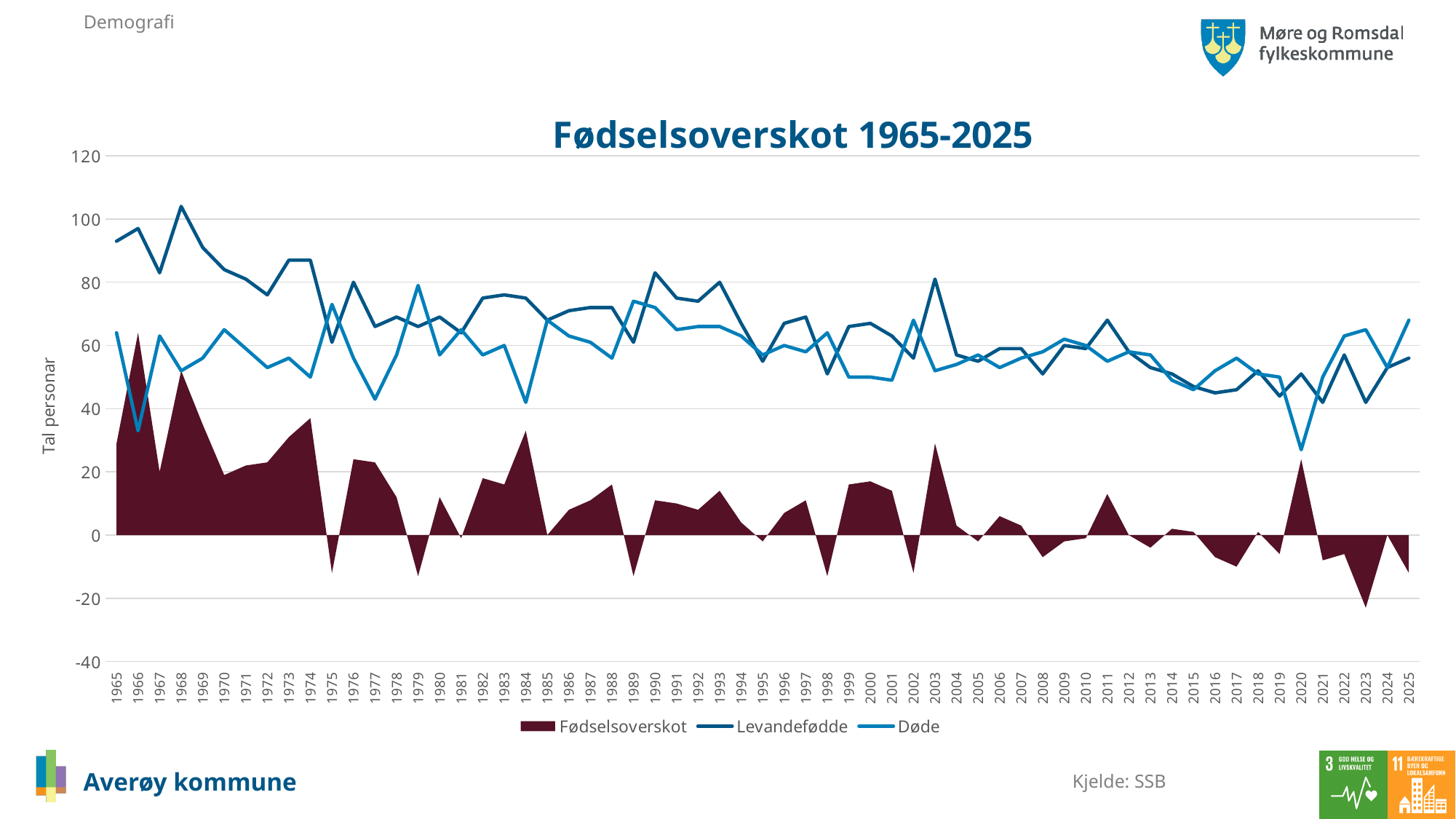
Does the Levandefødde series overall rise or fall from 1965 to 2025? fall Is the value for Fødselsoverskot in 2023 greater or less than -20? less What is the title of the chart? Fødselsoverskot 1965-2025 In which year does the Fødselsoverskot series reach its lowest value? 2023 Is the value for Levandefødde in 1968 greater or less than 100? greater Is the value for Døde in 1984 greater or less than 60? less In 2020, which is larger: Levandefødde or Døde? Levandefødde How many series does the chart legend list? 3 What is the label on the vertical axis of the chart? Tal personar In which year does the Levandefødde series reach its highest value? 1968 How many years are plotted along the x axis of the chart? 61